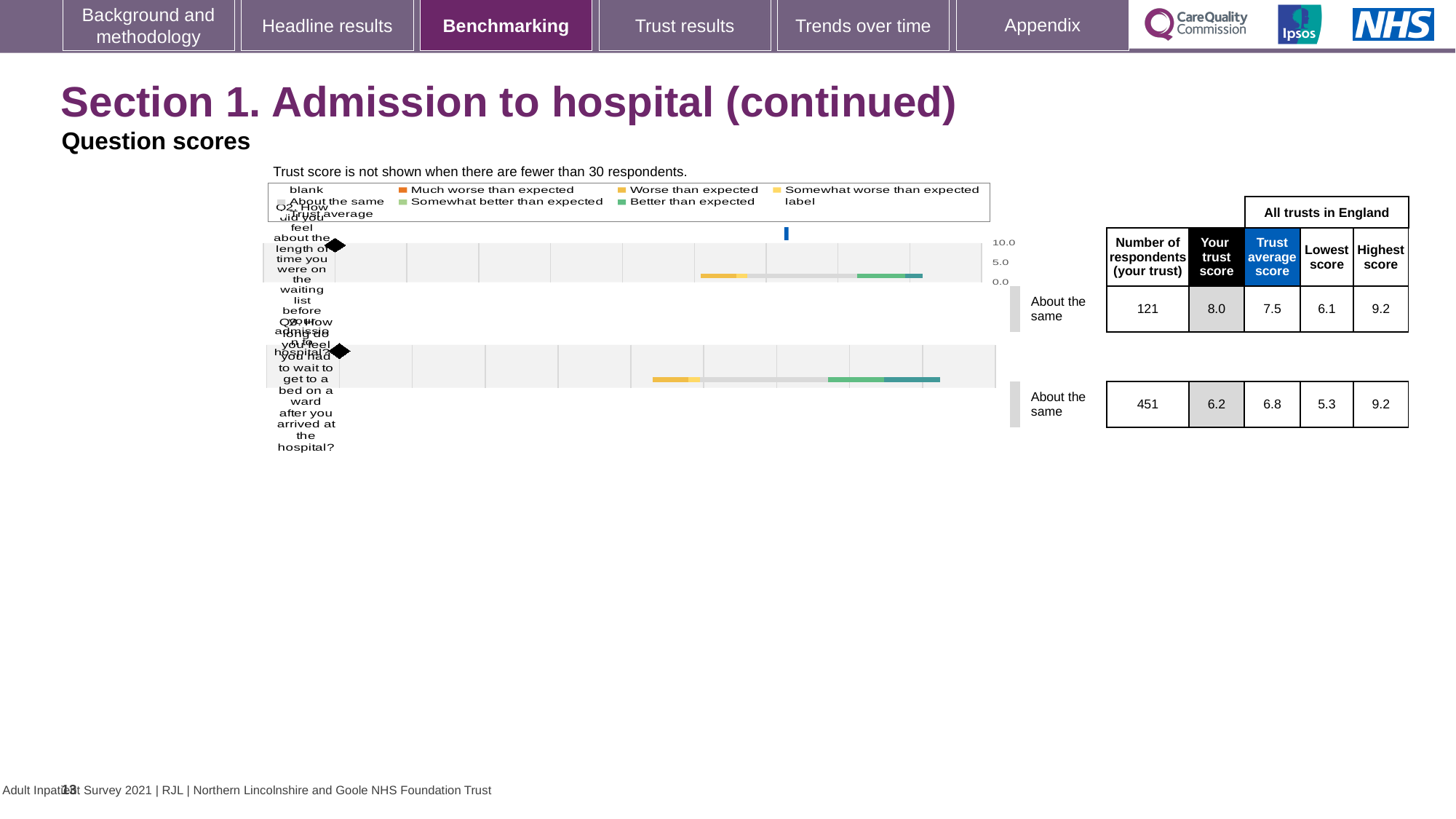
How many respondents answered Q3 for this trust? 451 What is the trust average score for all trusts in England for Q2? 7.5 What is the trust average score for all trusts in England for Q3? 6.8 What is the highest score among all trusts in England for Q3? 9.2 What benchmark category is shown next to both Q2 and Q3 on the chart? About the same What is the lowest score among all trusts in England for Q2? 6.1 Which question has the higher trust score, Q2 or Q3? Q2 What is the difference between the trust score and the trust average score for Q2? 0.5 What is the trust score for Q3 (how long do you feel you had to wait to get to a bed on a ward after you arrived at the hospital)? 6.2 What is the difference between the trust average score and the trust score for Q3? 0.6 How many questions are plotted on the chart? 2 What is the trust score for Q2 (how did you feel about the length of time you were on the waiting list before admission to hospital)? 8.0